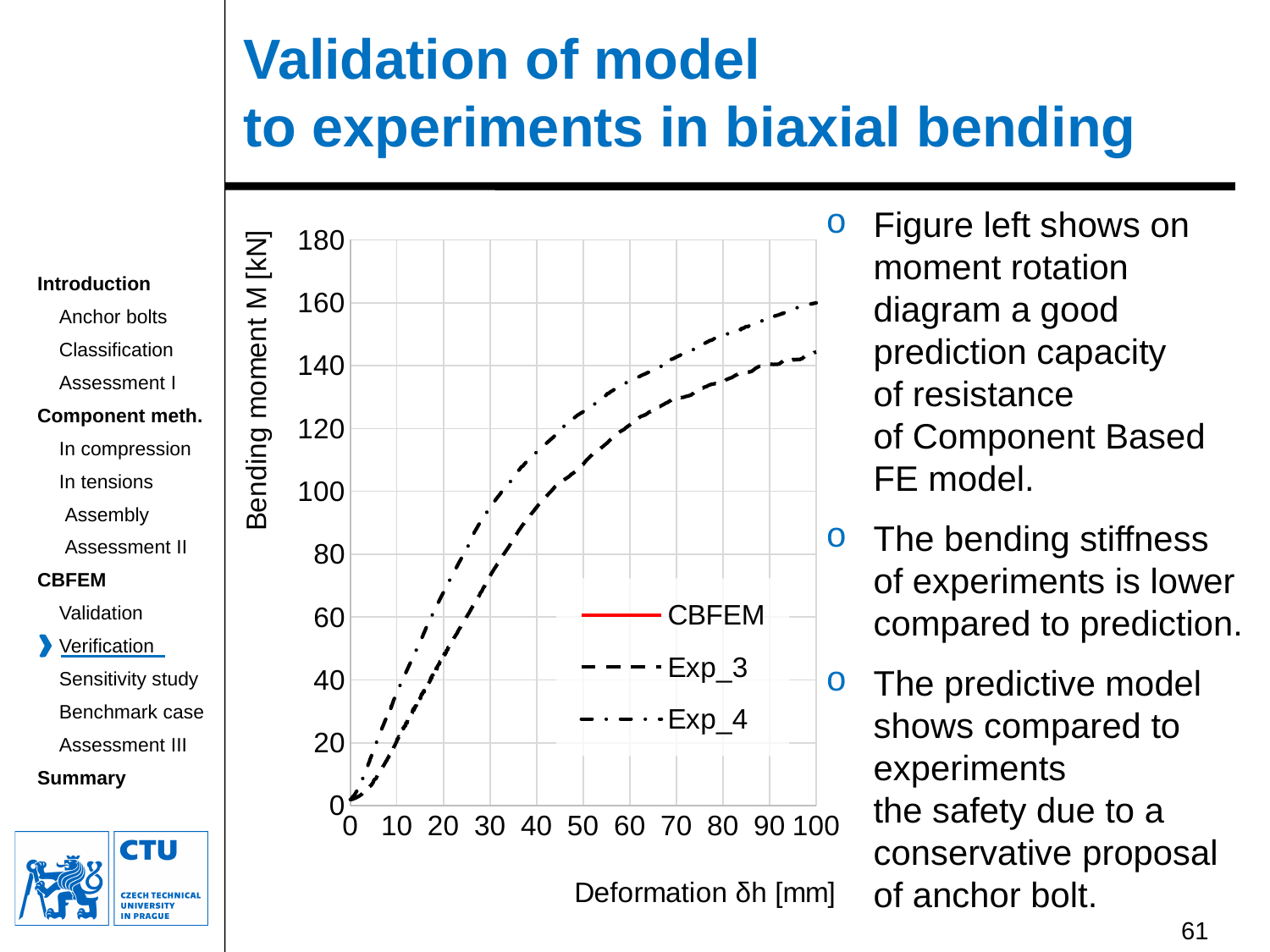
Is the bending moment for Exp_4 at 100 mm deformation greater or less than 140? greater What are the entries in the chart legend? CBFEM, Exp_3, Exp_4 Does the Exp_4 curve rise or fall as deformation increases along the x axis? rise Is the bending moment for Exp_3 at 20 mm deformation greater or less than 60? less What is the title of the vertical axis? Bending moment M [kN] Does the Exp_3 curve rise or fall as deformation increases along the x axis? rise Is the bending moment for Exp_3 at 100 mm deformation greater or less than 160? less Which plotted series reaches the highest bending moment at 100 mm deformation? Exp_4 What kind of chart is shown on the slide? line chart At a deformation of 60 mm, which series has the larger bending moment, Exp_3 or Exp_4? Exp_4 How many series does the legend list? 3